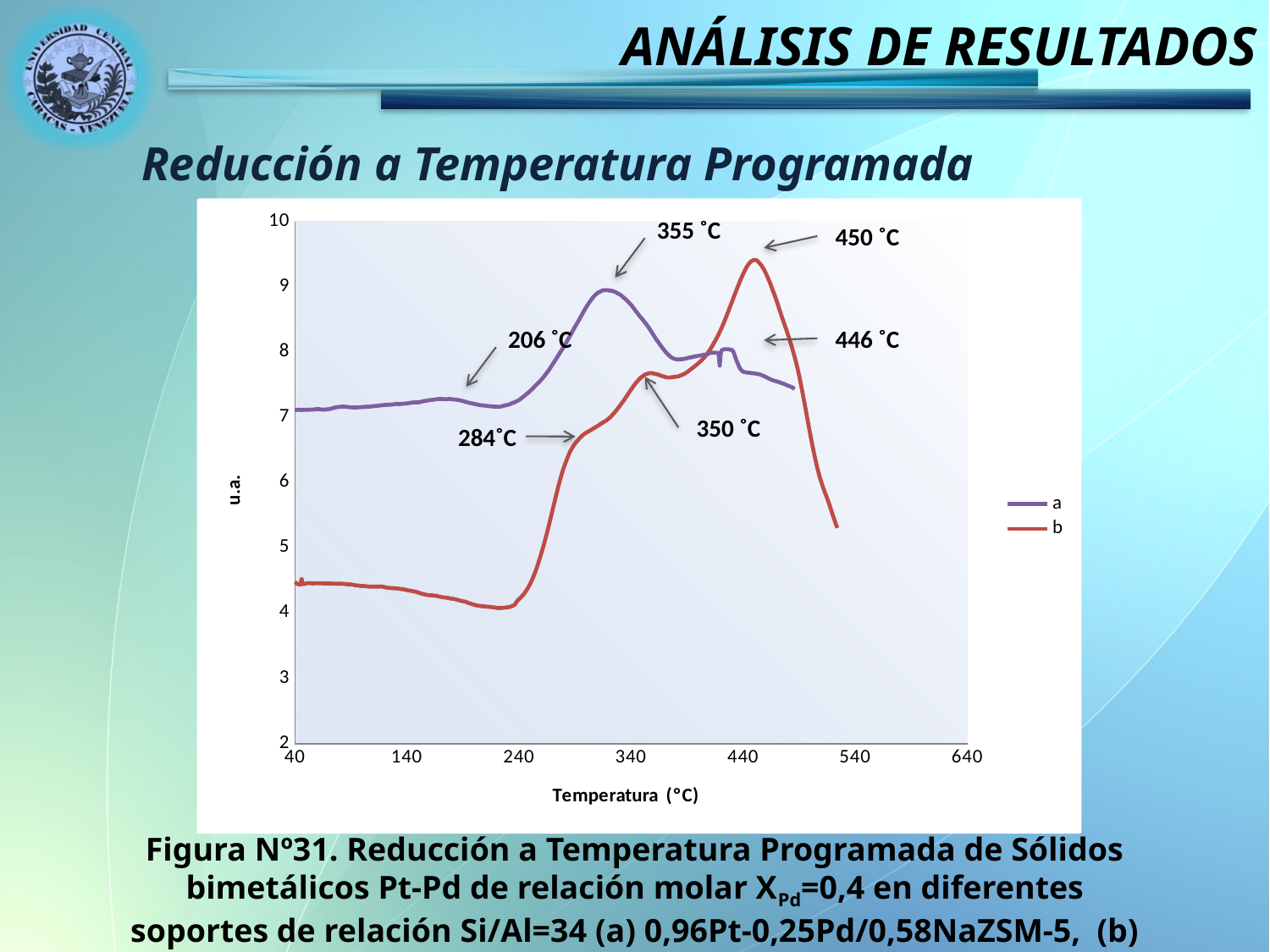
At what temperature is the highest peak of series b annotated? 450 °C Which series has the higher value at 140 °C, a or b? a At what temperature is the highest peak of series a annotated? 355 °C Is the value of series b at 240 °C greater or less than 5? less Which series reaches the higher maximum value, a or b? b How many temperature annotations are marked on the chart? 6 How many series does the legend list? 2 What are the legend entries of the chart? a and b At what temperature is the first annotated feature of series a (the small shoulder before the main peak)? 206 °C What is the label of the x axis? Temperatura (°C) What kind of chart is shown on the slide? line chart Is the maximum value of series b greater or less than 9? greater